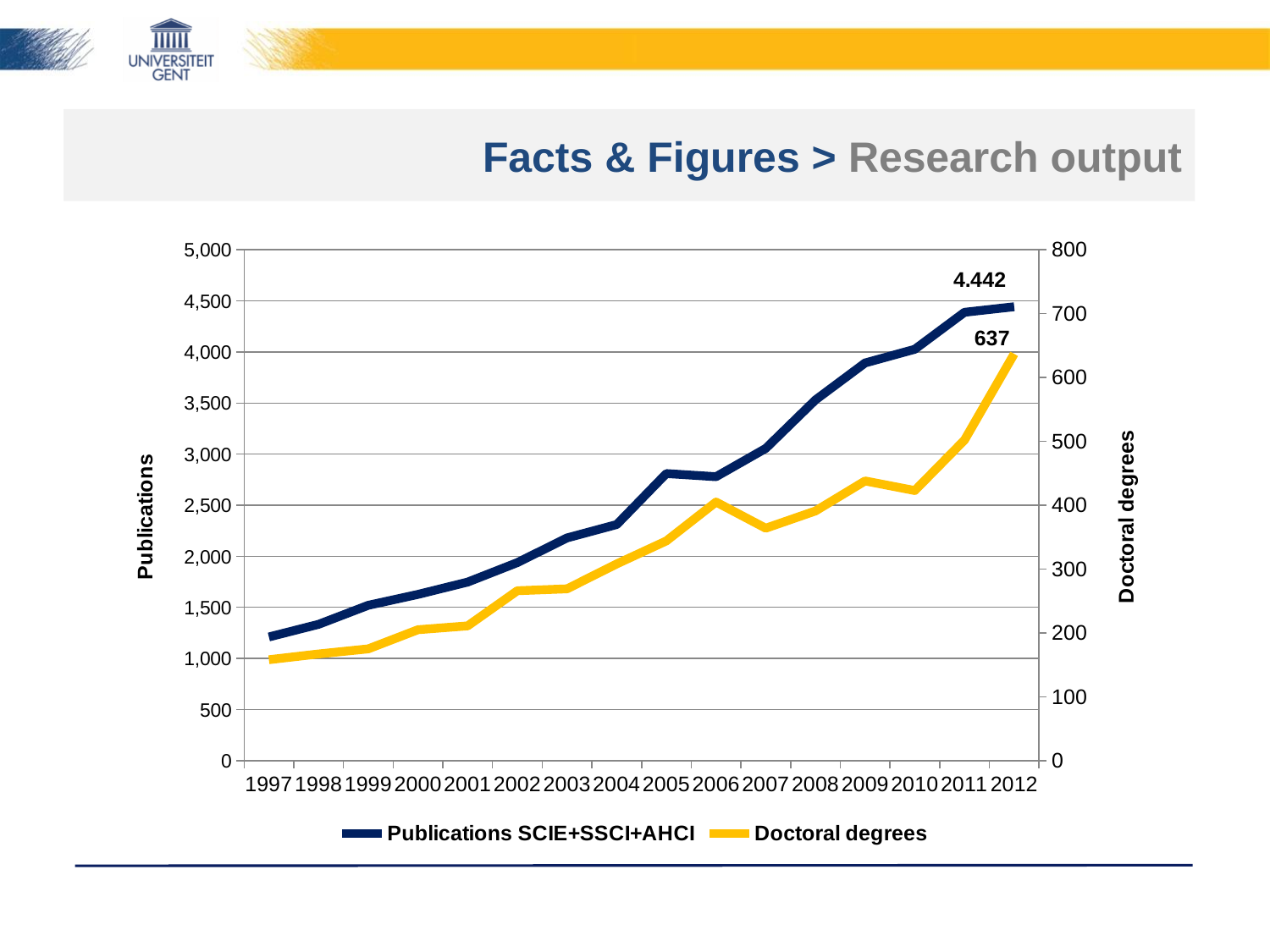
How many series does the legend list? 2 What is the label on the right-hand vertical axis? Doctoral degrees How many years are shown on the x axis? 16 In which year is the Publications SCIE+SSCI+AHCI value highest? 2012 Do the Publications SCIE+SSCI+AHCI values generally rise or fall from 1997 to 2012? Rise Is the value for Doctoral degrees in 2010 greater or less than 500? less What kind of chart is shown on the slide? Line chart What is the labelled value for Publications SCIE+SSCI+AHCI in 2012? 4.442 Is the value for Doctoral degrees in 1997 greater or less than 200? less Is the value for Publications SCIE+SSCI+AHCI in 2009 greater or less than 3,500? greater What is the labelled value for Doctoral degrees in 2012? 637